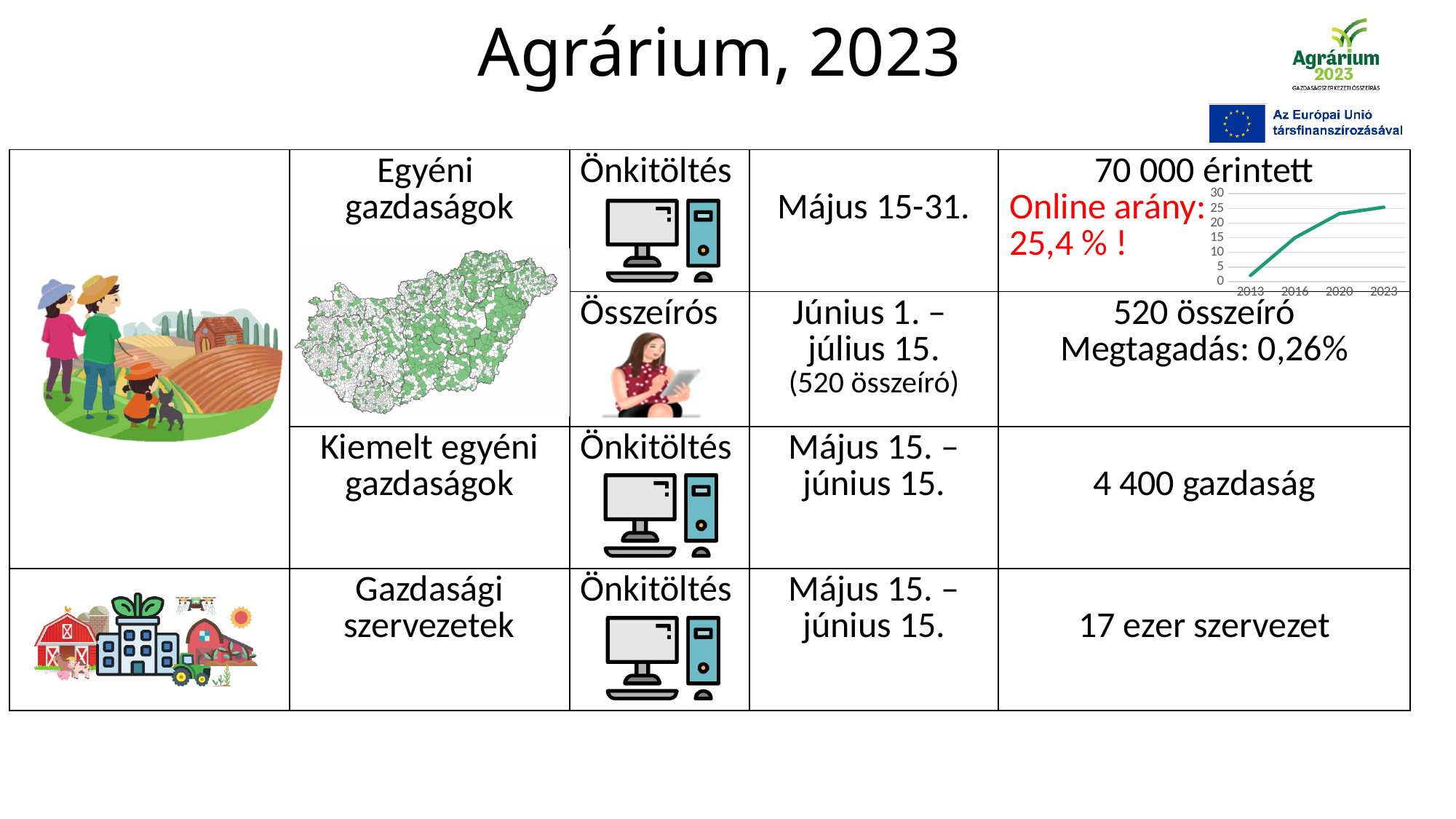
Do the values in the line chart rise or fall from 2013 to 2023? rise How many years are labelled on the x axis of the line chart? 4 In the line chart, is the value for 2016 greater or less than 20? less Which year has the lowest value in the line chart? 2013 What kind of chart is shown in the top-right cell of the table? line chart In the line chart, is the value for 2016 greater or less than 10? greater Which years are labelled on the x axis of the line chart? 2013, 2016, 2020, 2023 In the line chart, is the value for 2023 greater or less than 20? greater Which year has the highest value in the line chart? 2023 What is the highest tick value shown on the y axis of the line chart? 30 In the line chart, which is larger, the value for 2016 or the value for 2020? 2020